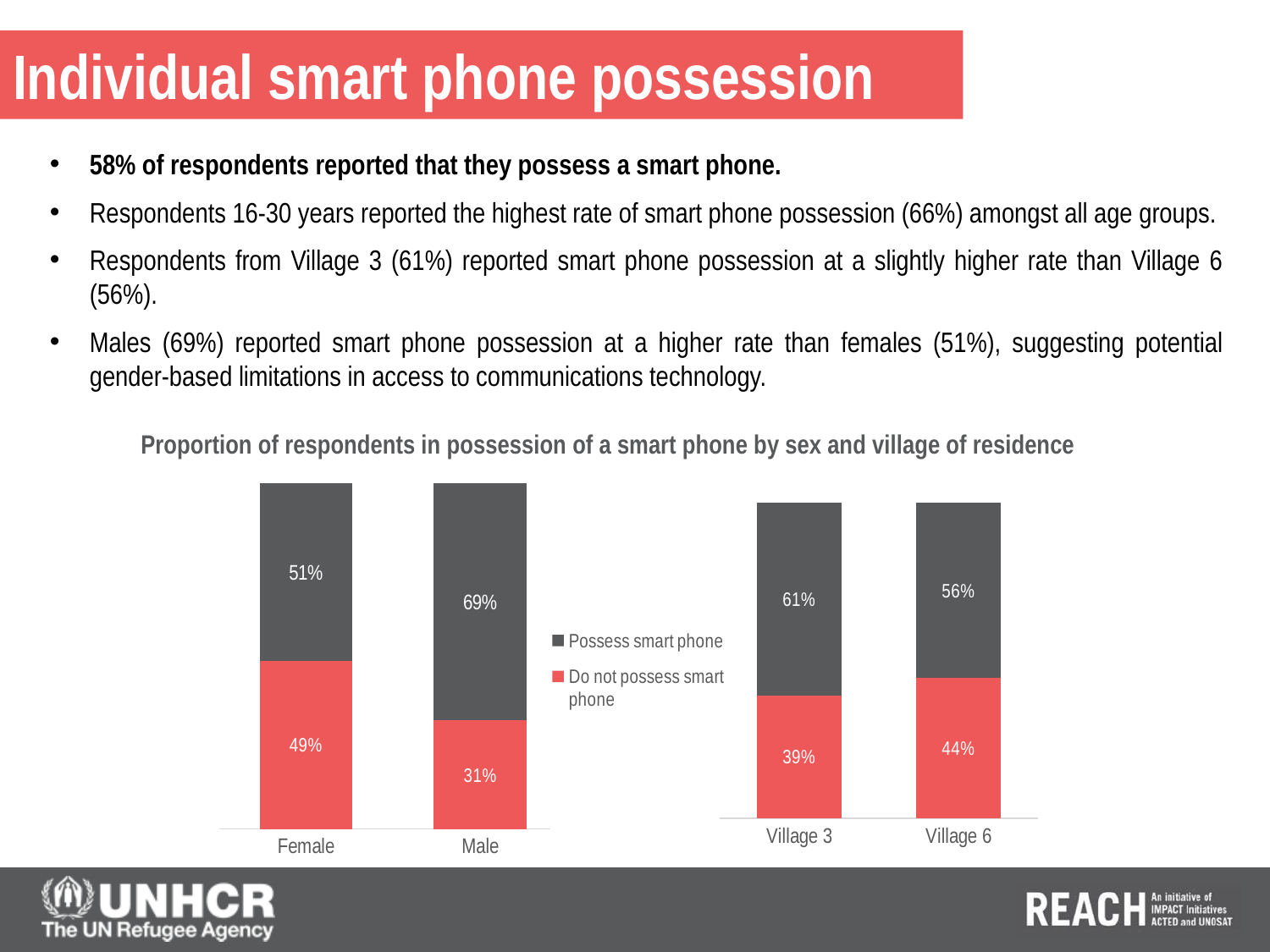
In the left chart (by sex), what percentage of males do not possess a smart phone? 31% In the left chart (by sex), what is the total of the two segments of the Female bar? 100% How many series does the legend list? 2 In the right chart (by village), what percentage of Village 3 respondents possess a smart phone? 61% In the left chart (by sex), what is the difference in percentage points between the male and female smart phone possession rates? 18 In the left chart (by sex), what percentage of females possess a smart phone? 51% In the right chart (by village), which village has the lower share possessing a smart phone? Village 6 In the right chart (by village), what is the difference in percentage points between Village 3 and Village 6 smart phone possession rates? 5 In the left chart (by sex), which category has the higher share possessing a smart phone, Female or Male? Male What type of chart is used on this slide? Stacked bar chart In the right chart (by village), what percentage of Village 6 respondents do not possess a smart phone? 44% What is the title of the chart on the slide? Proportion of respondents in possession of a smart phone by sex and village of residence